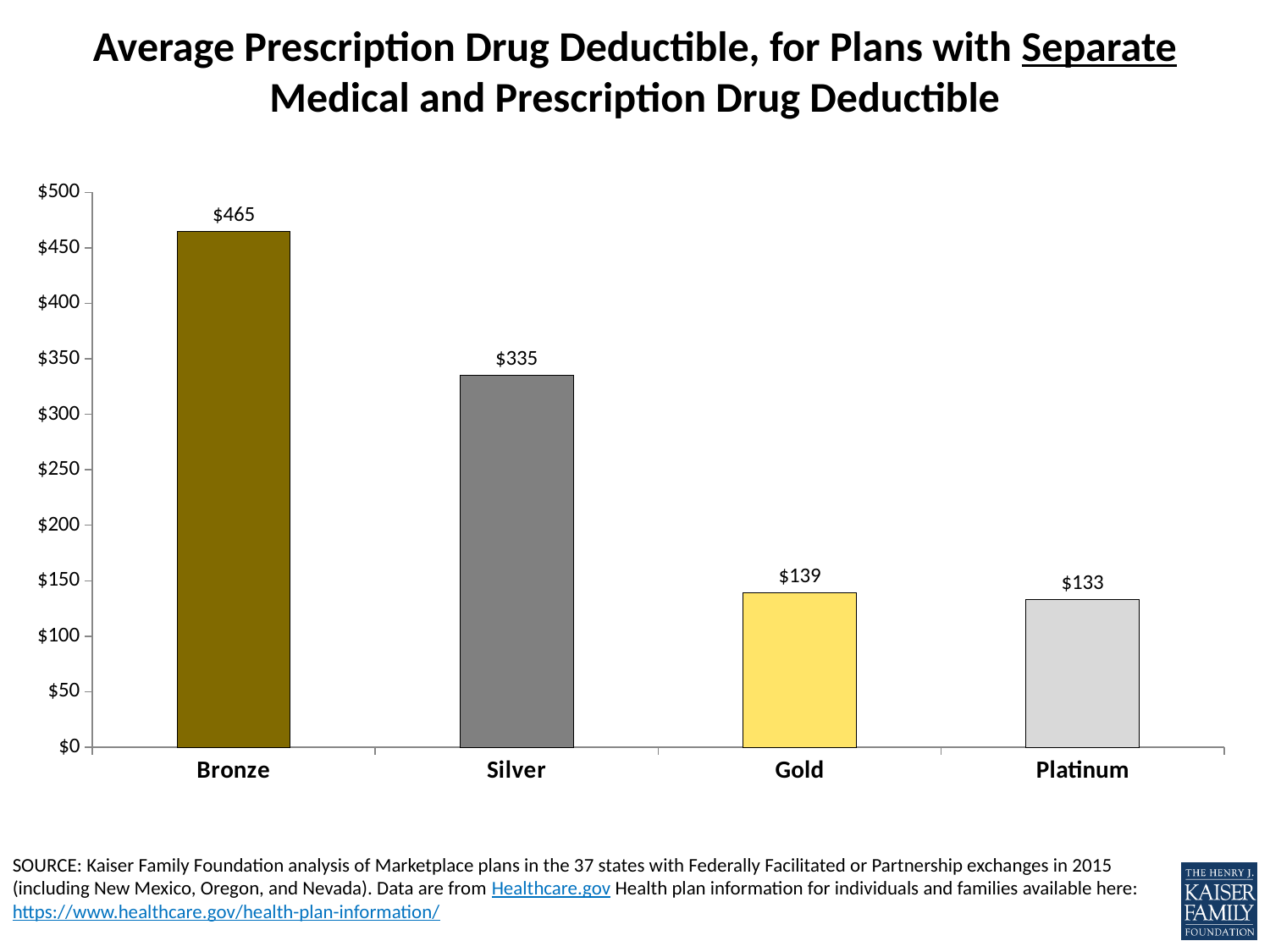
Which plan type has the highest average prescription drug deductible? Bronze What kind of chart is shown on the slide? Bar chart What is the difference between the Bronze and Silver average prescription drug deductibles? $130 How many plan types are shown on the chart? 4 What is the average prescription drug deductible for Bronze plans? $465 What is the average prescription drug deductible for Gold plans? $139 What is the difference between the Gold and Platinum average prescription drug deductibles? $6 Which plan type has the lowest average prescription drug deductible? Platinum What is the average prescription drug deductible for Platinum plans? $133 Do the values rise or fall moving from Bronze to Platinum along the x axis? Fall Which has a larger average prescription drug deductible, Silver or Gold? Silver What is the average prescription drug deductible for Silver plans? $335